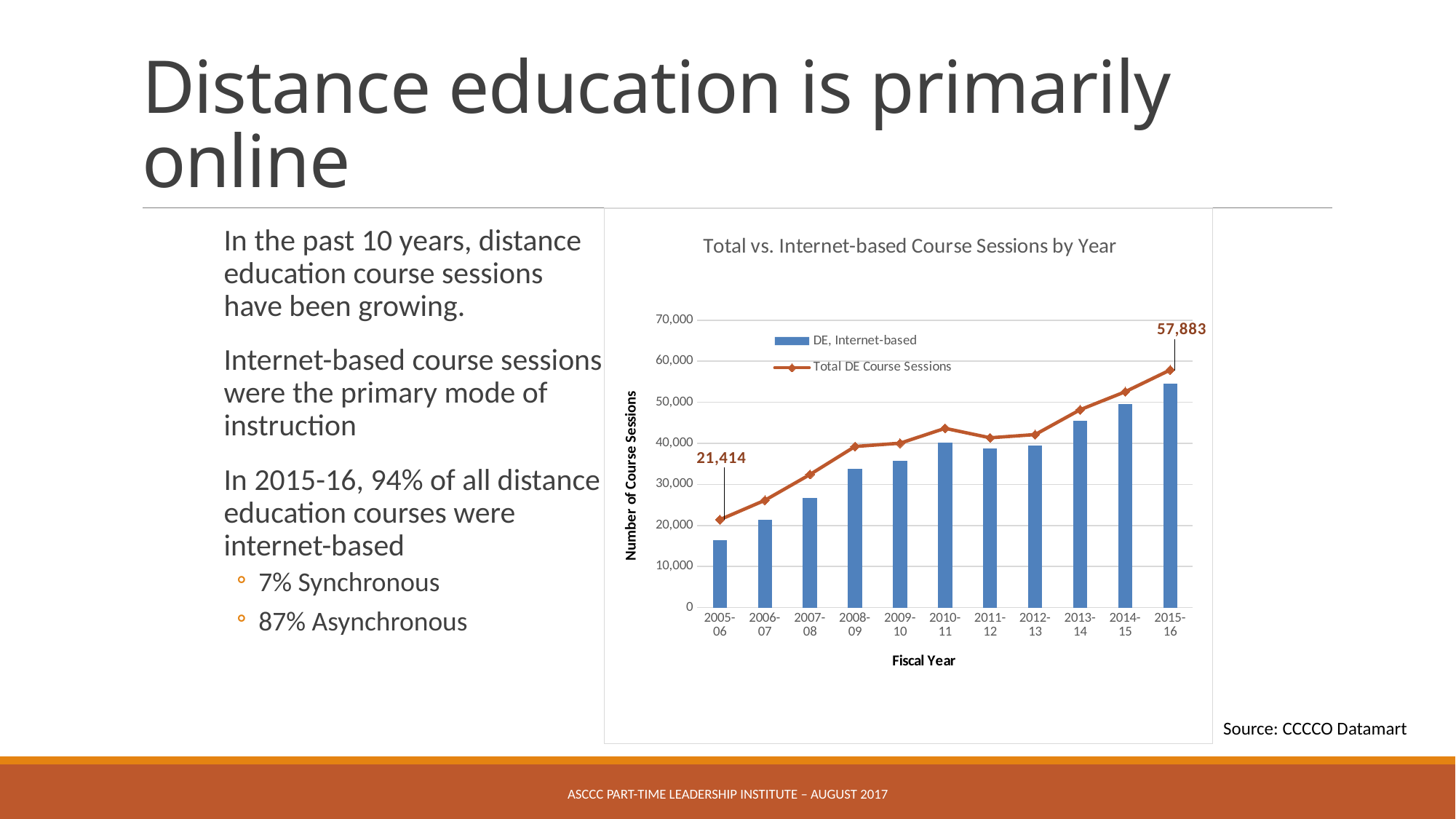
Is the value for DE, Internet-based sessions in 2015-16 greater or less than 50,000? greater Do Total DE Course Sessions generally rise or fall from 2005-06 to 2015-16? Rise What is the title of the chart's x axis? Fiscal Year Is the value for DE, Internet-based sessions in 2005-06 greater or less than 20,000? less What kind of chart is shown on the slide? Combined bar and line chart What is the value of Total DE Course Sessions for fiscal year 2005-06? 21,414 What is the value of Total DE Course Sessions for fiscal year 2015-16? 57,883 Which fiscal year has the lowest value for DE, Internet-based sessions? 2005-06 Which fiscal year has the highest Total DE Course Sessions? 2015-16 How many series does the chart's legend list? 2 By how much did Total DE Course Sessions increase from 2005-06 to 2015-16? 36,469 How many fiscal years are shown on the x axis of the chart? 11